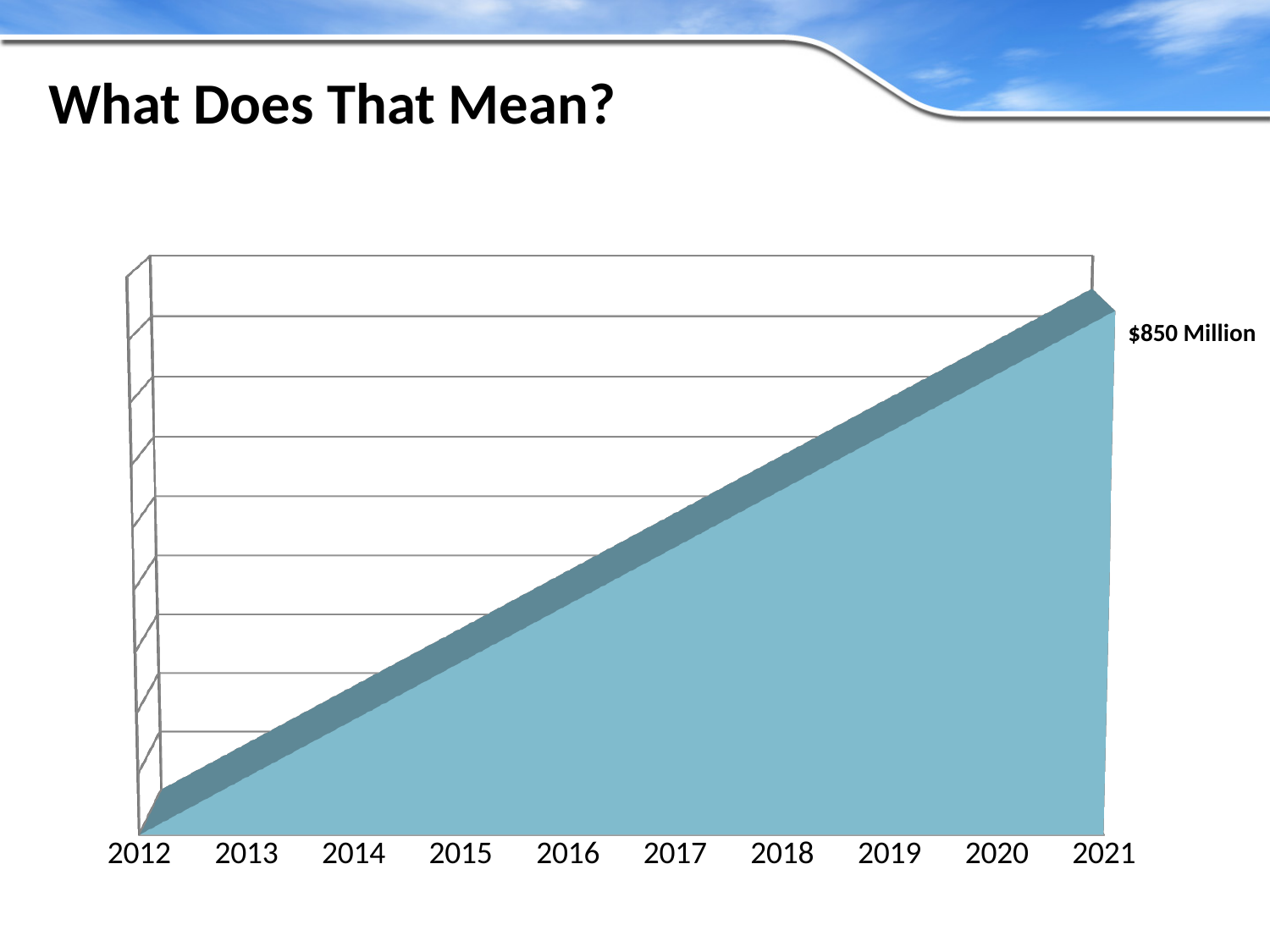
What is the title of the slide containing the chart? What Does That Mean? What is the last year shown on the x axis of the chart? 2021 What value is labelled on the chart for 2021? $850 Million How many data labels are printed on the chart? 1 How many years are shown along the x axis of the chart? 10 Which year has the larger value, 2015 or 2019? 2019 What is the first year shown on the x axis of the chart? 2012 Which year has the larger value, 2013 or 2017? 2017 Which year has the highest value in the chart? 2021 What kind of chart is shown on the slide? area chart Which year has the lowest value in the chart? 2012 Do the values in the chart rise or fall from 2012 to 2021? rise